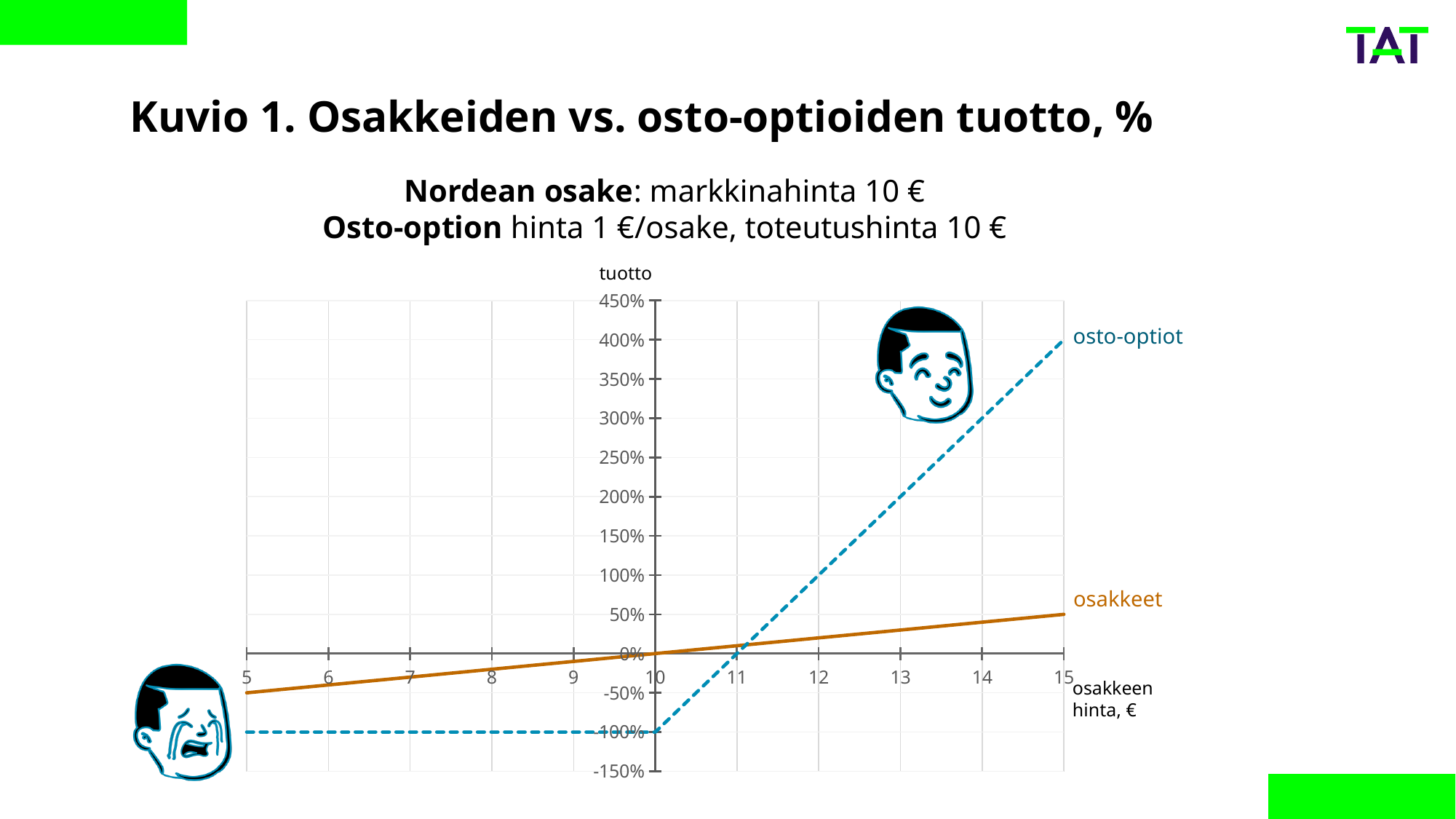
What is the label of the x axis? osakkeen hinta, € At a share price of 15 €, which series has the higher return, osto-optiot or osakkeet? osto-optiot How many series are plotted in the chart? 2 Does the osakkeet line rise or fall as the share price increases from 5 € to 15 €? rises What is the return (tuotto) for osto-optiot when the share price is 15 €? 400% What is the return for osakkeet when the share price is 10 €? 0% What is the difference between the osto-optiot return and the osakkeet return at a share price of 15 €? 350% What kind of chart is shown on the slide? line chart What is the return for osto-optiot when the share price is 5 €? -100% What is the return (tuotto) for osakkeet when the share price is 15 €? 50% What is the return for osakkeet when the share price is 5 €? -50% At a share price of 5 €, which series has the lower return, osto-optiot or osakkeet? osto-optiot